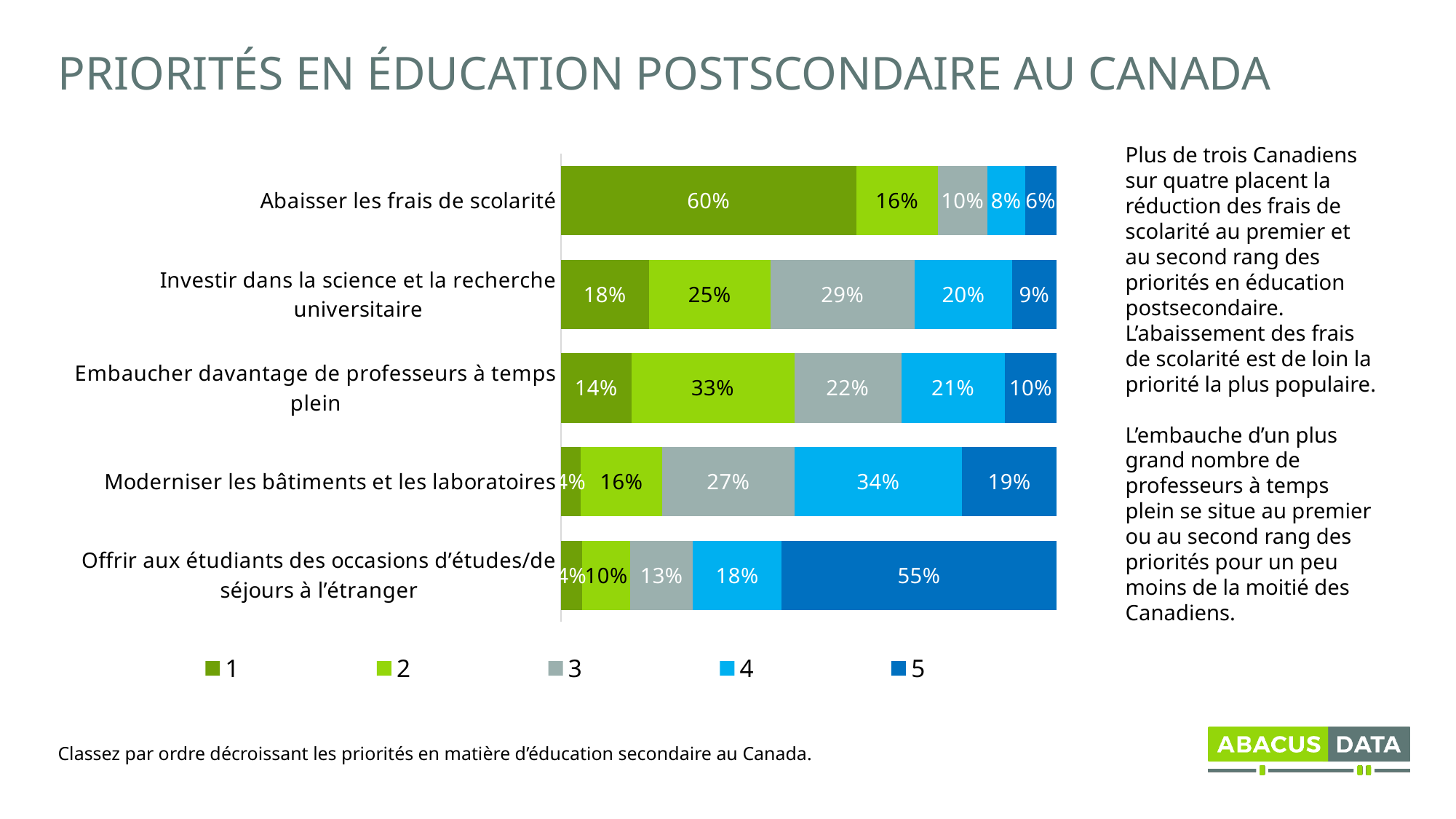
How many series does the legend list? 5 Which category has the highest value for series 5? Offrir aux étudiants des occasions d'études/de séjours à l'étranger Which category has the highest value for series 1? Abaisser les frais de scolarité What is the total of the stacked bar for "Embaucher davantage de professeurs à temps plein"? 100% What is the value for series 2 on the "Embaucher davantage de professeurs à temps plein" bar? 33% How many categories are shown on the chart? 5 How much larger is the series 1 value for "Abaisser les frais de scolarité" than the series 1 value for "Investir dans la science et la recherche universitaire"? 44 percentage points What kind of chart is shown on the slide? Stacked bar chart What is the value for series 3 on the "Investir dans la science et la recherche universitaire" bar? 29% What percentage of respondents ranked "Abaisser les frais de scolarité" as priority 1? 60% Which has the larger series 4 value: "Moderniser les bâtiments et les laboratoires" or "Embaucher davantage de professeurs à temps plein"? Moderniser les bâtiments et les laboratoires What is the value for series 5 on the "Offrir aux étudiants des occasions d'études/de séjours à l'étranger" bar? 55%